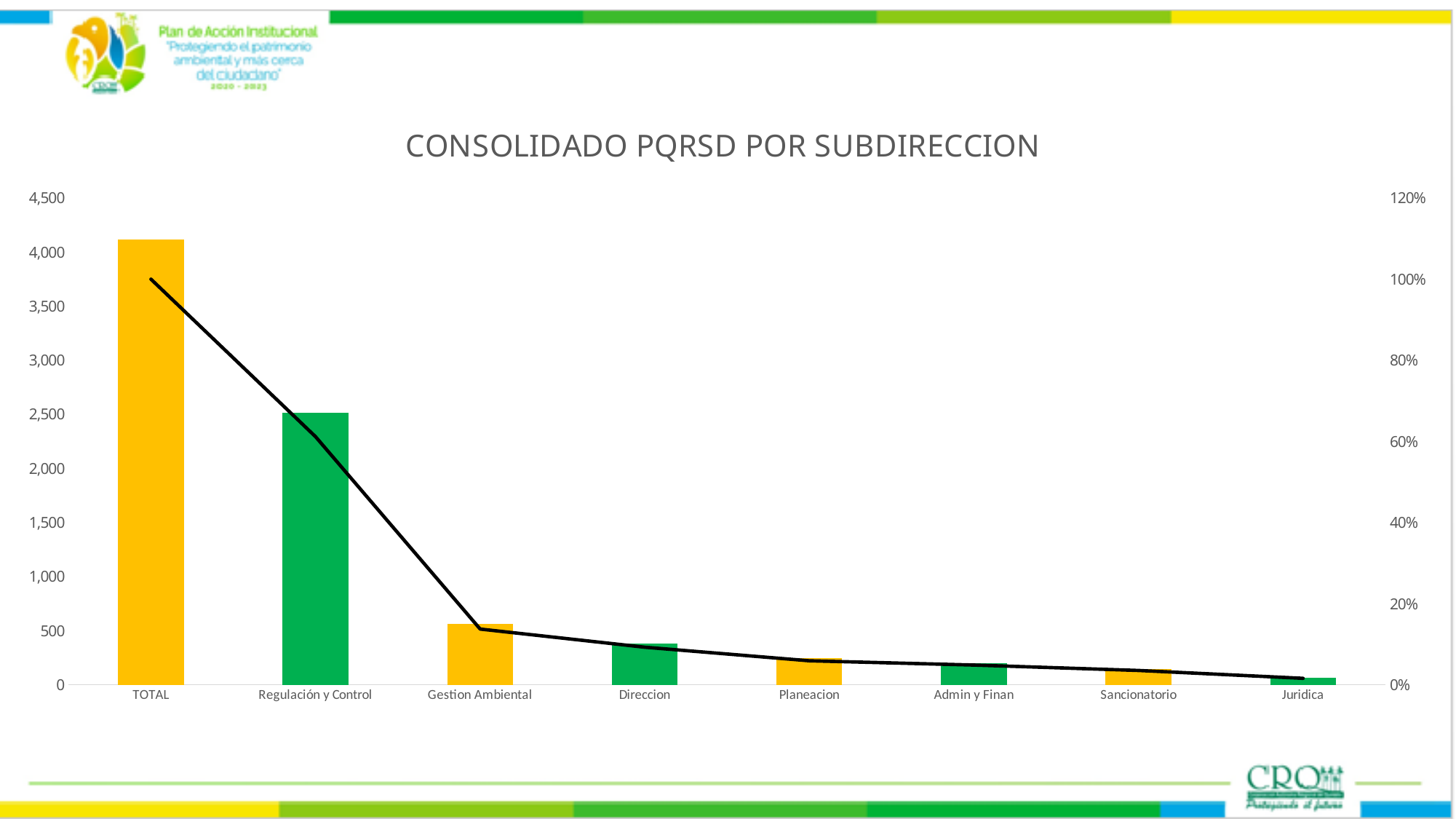
How many categories are shown on the x axis? 8 Is the bar for TOTAL greater or less than 4,000? greater Which category has the tallest bar? TOTAL Do the bar values rise or fall from left to right along the x axis? fall Which category has the shortest bar? Juridica Which subdirección (excluding TOTAL) has the tallest bar? Regulación y Control Which bar is taller, Direccion or Planeacion? Direccion What value does the line reach for TOTAL on the right-hand axis? 100% What kind of chart is shown on the slide? Bar chart with a line What is the title of the chart? CONSOLIDADO PQRSD POR SUBDIRECCION Is the bar for Regulación y Control greater or less than 3,000? less